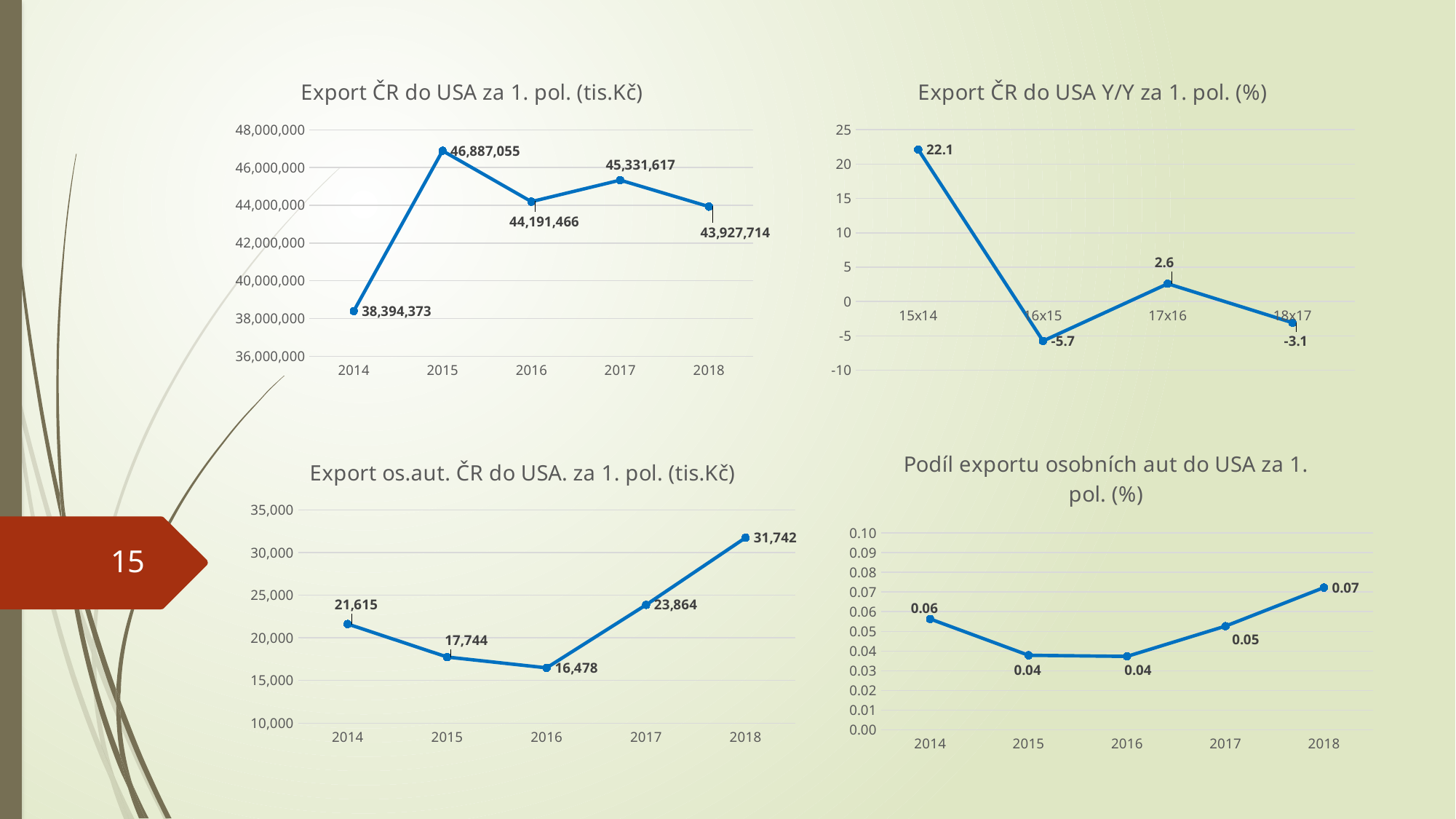
In the chart titled 'Export ČR do USA za 1. pol. (tis.Kč)', what is the value for 2015? 46,887,055 In the chart titled 'Podíl exportu osobních aut do USA za 1. pol. (%)', what is the difference between the 2018 and 2015 values? 0.03 In the chart titled 'Export ČR do USA Y/Y za 1. pol. (%)', which period has the highest value? 15x14 In the chart titled 'Export os.aut. ČR do USA. za 1. pol. (tis.Kč)', what is the value for 2018? 31,742 What type of chart is the chart titled 'Export os.aut. ČR do USA. za 1. pol. (tis.Kč)'? Line chart In the chart titled 'Export ČR do USA Y/Y za 1. pol. (%)', what is the value for 16x15? -5.7 In the chart titled 'Podíl exportu osobních aut do USA za 1. pol. (%)', what is the value for 2017? 0.05 In the chart titled 'Export ČR do USA za 1. pol. (tis.Kč)', which year has the lowest value? 2014 In the chart titled 'Export ČR do USA Y/Y za 1. pol. (%)', how many data points are plotted? 4 In the chart titled 'Export os.aut. ČR do USA. za 1. pol. (tis.Kč)', which year has the lowest value? 2016 In the chart titled 'Export os.aut. ČR do USA. za 1. pol. (tis.Kč)', is the value for 2017 larger than the value for 2014? Yes In the chart titled 'Export ČR do USA za 1. pol. (tis.Kč)', what is the difference between the 2017 and 2018 values? 1,403,903